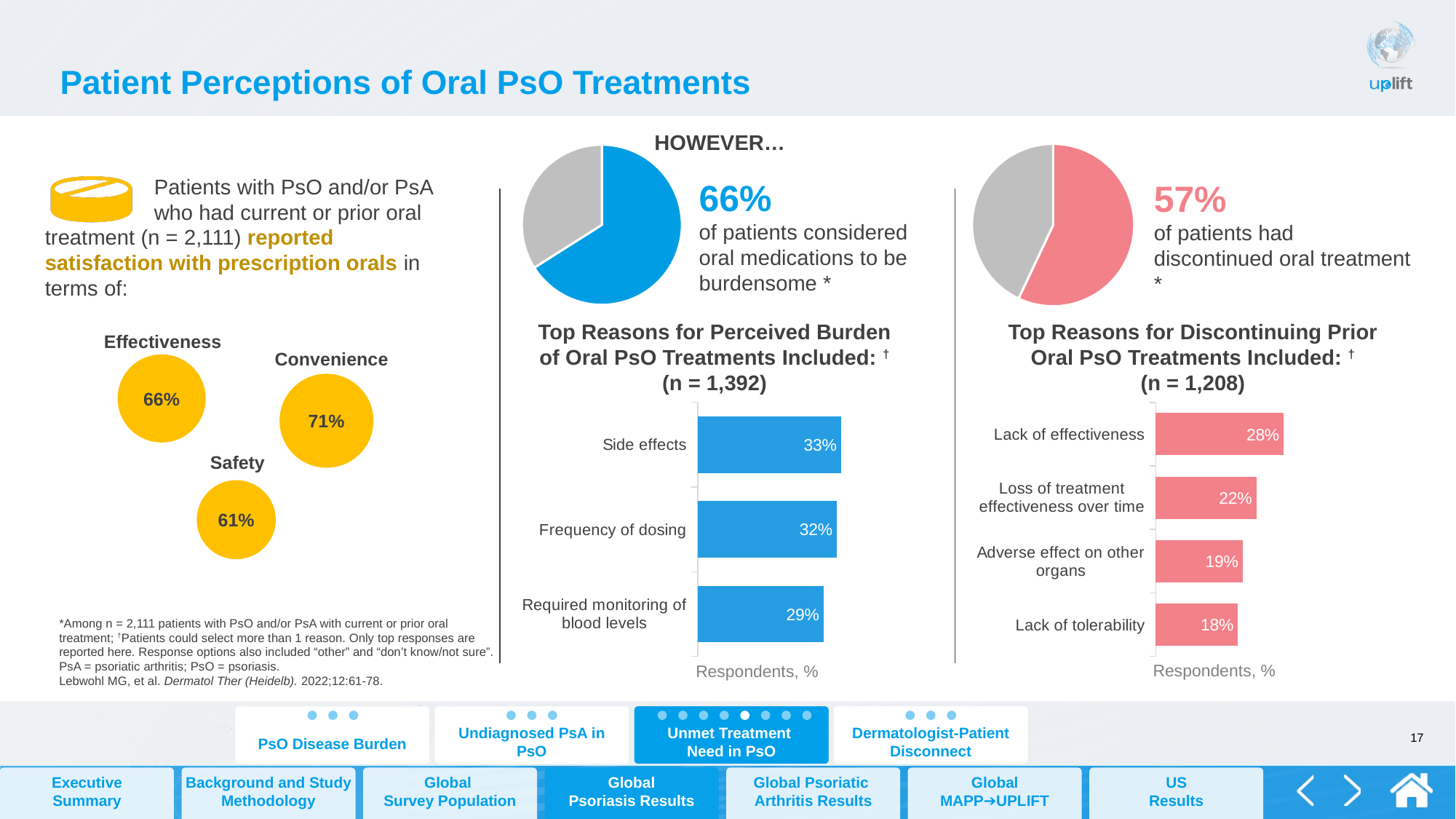
In the pie chart in the middle of the slide, what percentage of patients considered oral medications to be burdensome? 66% In the 'Top Reasons for Discontinuing Prior Oral PsO Treatments' chart, what percentage of respondents cited lack of effectiveness? 28% In the 'Top Reasons for Discontinuing Prior Oral PsO Treatments' chart, what is the difference between the percentages for lack of effectiveness and loss of treatment effectiveness over time? 6% What type of chart is used to show the top reasons for perceived burden of oral PsO treatments? Bar chart In the 'Top Reasons for Discontinuing Prior Oral PsO Treatments' chart, which reason has the lowest percentage? Lack of tolerability In the 'Top Reasons for Perceived Burden of Oral PsO Treatments' chart, what is the difference between the percentages for side effects and frequency of dosing? 1% In the 'Top Reasons for Perceived Burden of Oral PsO Treatments' chart, what percentage of respondents cited required monitoring of blood levels? 29% In the pie chart on the right of the slide, what percentage of patients had discontinued oral treatment? 57% In the 'Top Reasons for Discontinuing Prior Oral PsO Treatments' chart, how many reasons are listed? 4 In the 'Top Reasons for Perceived Burden of Oral PsO Treatments' chart, which reason has the highest percentage? Side effects In the 'Top Reasons for Discontinuing Prior Oral PsO Treatments' chart, which is larger: adverse effect on other organs or lack of tolerability? Adverse effect on other organs In the 'Top Reasons for Perceived Burden of Oral PsO Treatments' chart, what percentage of respondents cited side effects? 33%